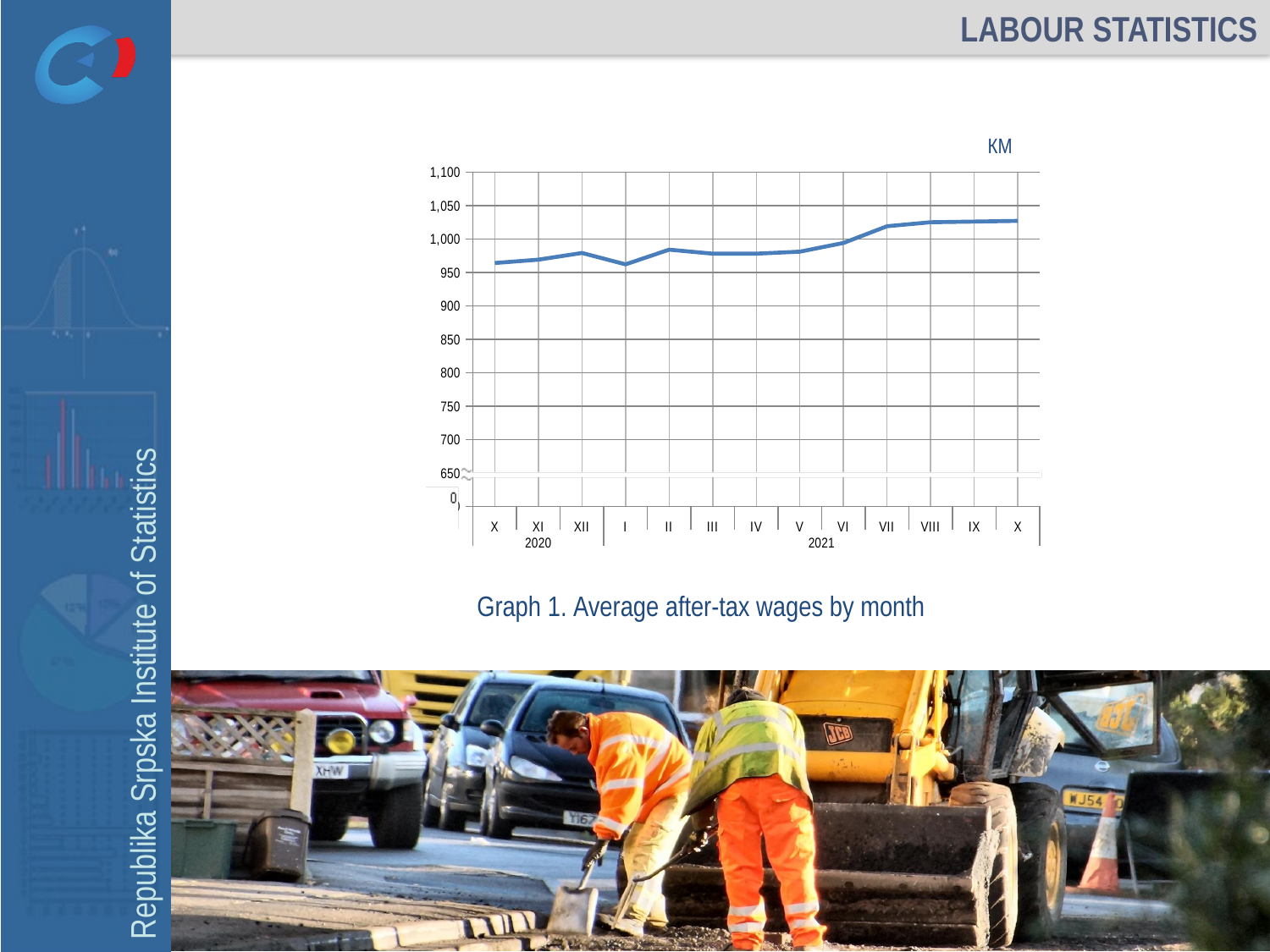
Is the value for month X of 2020 greater or less than 1,000? less How many monthly data points are plotted on the chart? 13 Which is larger, the value for month I of 2021 or the value for month VIII of 2021? VIII of 2021 Is the value for month I of 2021 greater or less than 1,000? less Overall, do the values rise or fall from month X of 2020 to month X of 2021? rise Which is larger, the value for month X of 2020 or the value for month X of 2021? X of 2021 Is the value for month XII of 2020 greater or less than 950? greater What is the title of the chart on the slide? Graph 1. Average after-tax wages by month What kind of chart is shown on the slide? line chart What unit is shown above the chart's vertical axis? KM